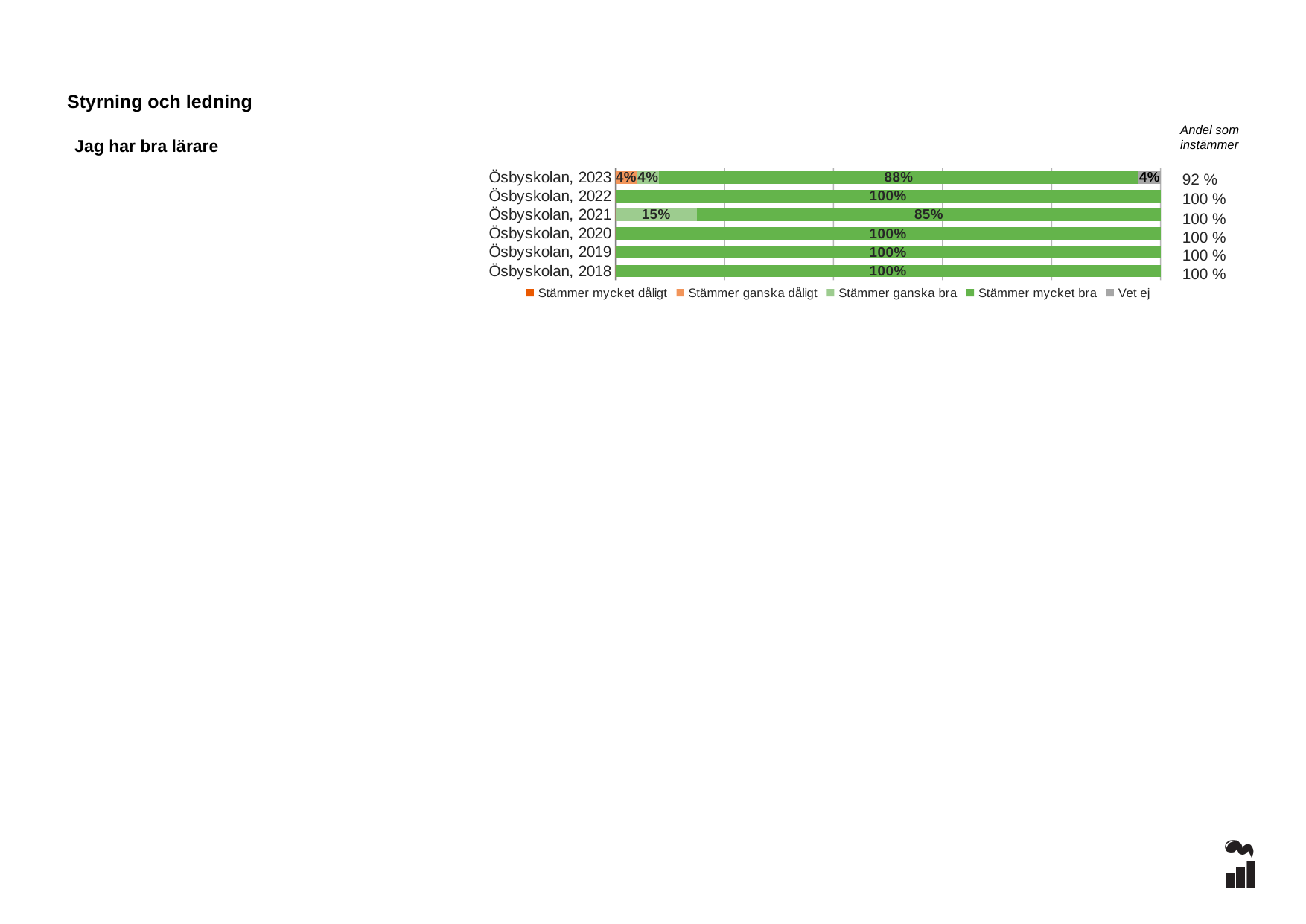
What is the difference between the "Stämmer mycket bra" share for Ösbyskolan, 2022 and Ösbyskolan, 2023? 12% Which is larger: the "Stämmer mycket bra" share for Ösbyskolan, 2021 or for Ösbyskolan, 2023? Ösbyskolan, 2023 What percentage of respondents answered "Stämmer mycket bra" for Ösbyskolan, 2021? 85% What percentage of respondents answered "Vet ej" for Ösbyskolan, 2023? 4% What percentage of respondents answered "Stämmer mycket bra" for Ösbyskolan, 2023? 88% Which year has the lowest "Stämmer mycket bra" share? Ösbyskolan, 2021 What is the title of the statement the chart is about? Jag har bra lärare How many categories (year rows) are shown in the chart? 6 What kind of chart is shown on the slide? Stacked bar chart What percentage of respondents answered "Stämmer ganska bra" for Ösbyskolan, 2021? 15% What is the "Andel som instämmer" value shown for Ösbyskolan, 2023? 92 % How many series does the legend list? 5